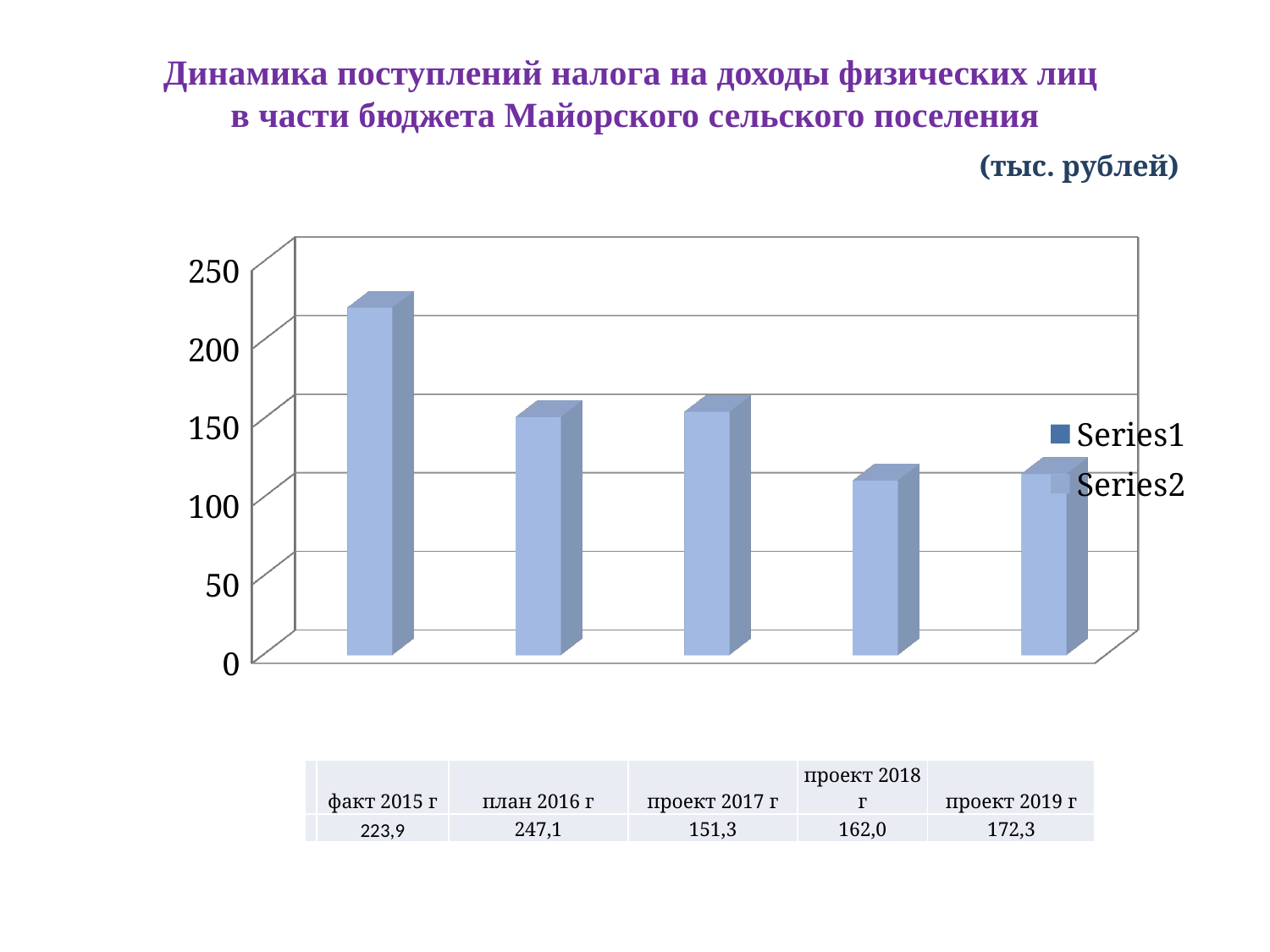
What is the value for проект 2018 г? 162,0 How many categories are shown on the chart? 5 What kind of chart is shown on the slide? bar chart What is the difference between the values for проект 2019 г and проект 2018 г? 10,3 What is the difference between the values for факт 2015 г and проект 2017 г? 72,6 How many series does the legend list? 2 What is the value for план 2016 г? 247,1 Is the value for факт 2015 г greater or less than 200? greater Which is larger, the value for факт 2015 г or the value for проект 2017 г? факт 2015 г What is the value for проект 2017 г? 151,3 What is the value for проект 2019 г? 172,3 What is the value for факт 2015 г? 223,9